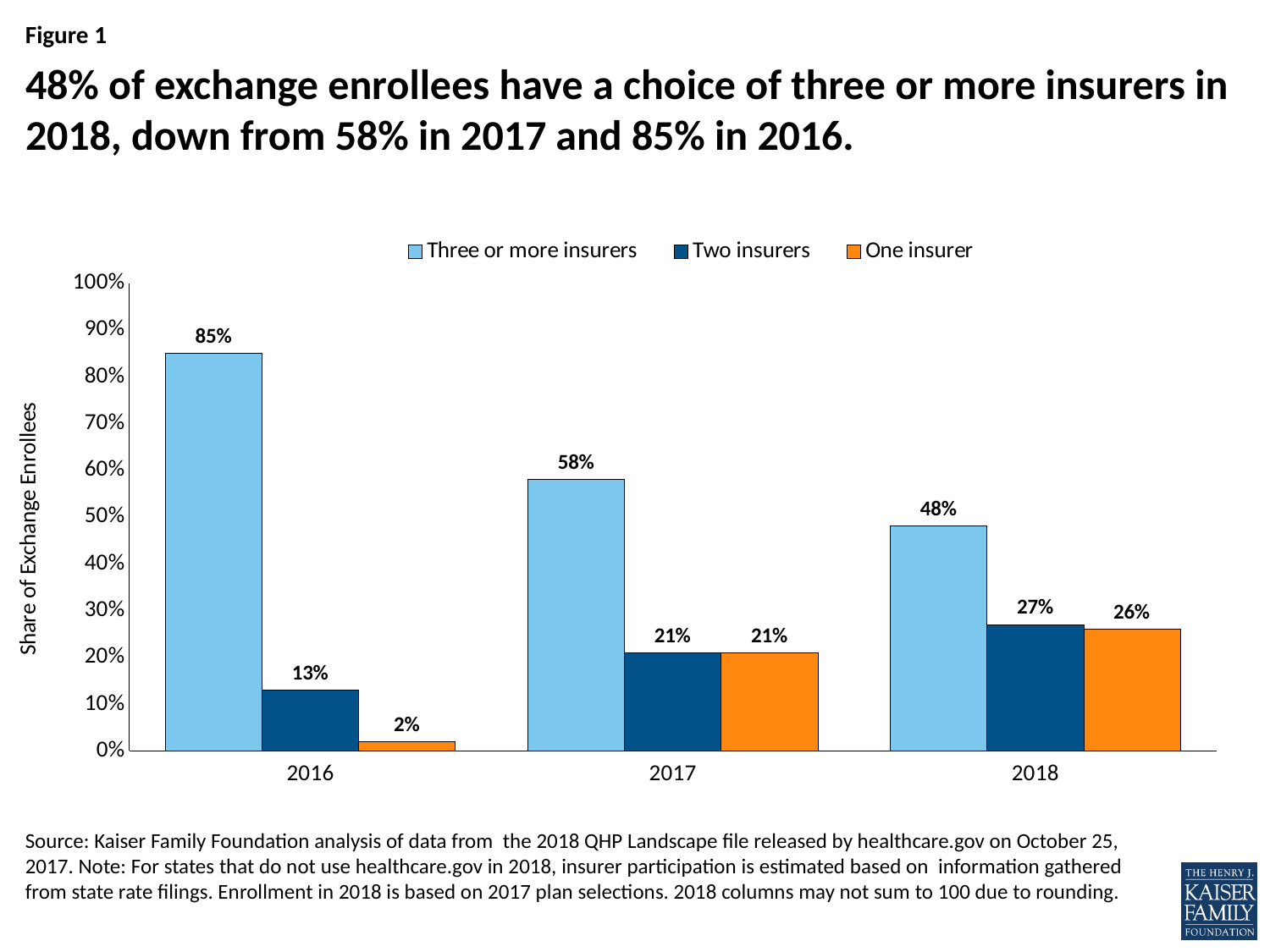
In which year is the share of enrollees with only one insurer the highest? 2018 Which is larger in 2018: the share with Two insurers or the share with One insurer? Two insurers How many years are shown on the x axis? 3 Is the value for Three or more insurers in 2017 greater or less than 50%? greater In which year is the share of enrollees with three or more insurers the lowest? 2018 What kind of chart is shown? Bar chart What is the value for One insurer in 2016? 2% What is the difference between the Three or more insurers share in 2016 and in 2018? 37% How many series does the legend list? 3 Does the share of enrollees with three or more insurers rise or fall from 2016 to 2018? Fall What share of exchange enrollees had a choice of three or more insurers in 2016? 85% What is the value for Two insurers in 2018? 27%